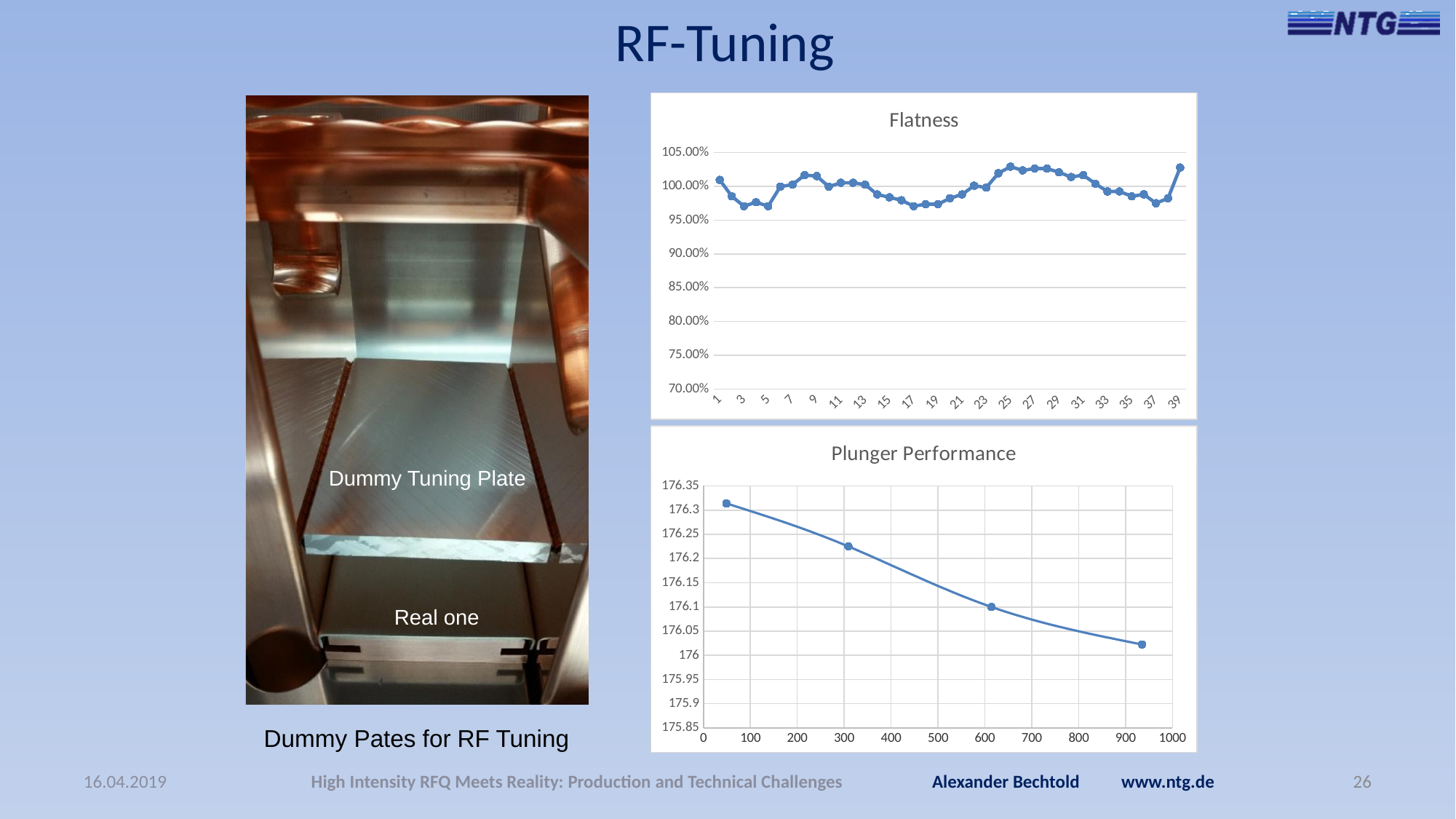
In the Plunger Performance chart, is the value of the point near x = 300 greater or less than 176.25? less In the Plunger Performance chart, is the value of the last point (near x = 930) greater or less than 176.05? less In the Plunger Performance chart, is the value of the last point (near x = 930) greater or less than 176? greater What is the title of the lower chart on the slide? Plunger Performance In the Plunger Performance chart, do the values rise or fall as the x value increases? fall What type of chart is the Plunger Performance chart? line chart What type of chart is the Flatness chart? line chart In the Plunger Performance chart, how many data points are plotted? 4